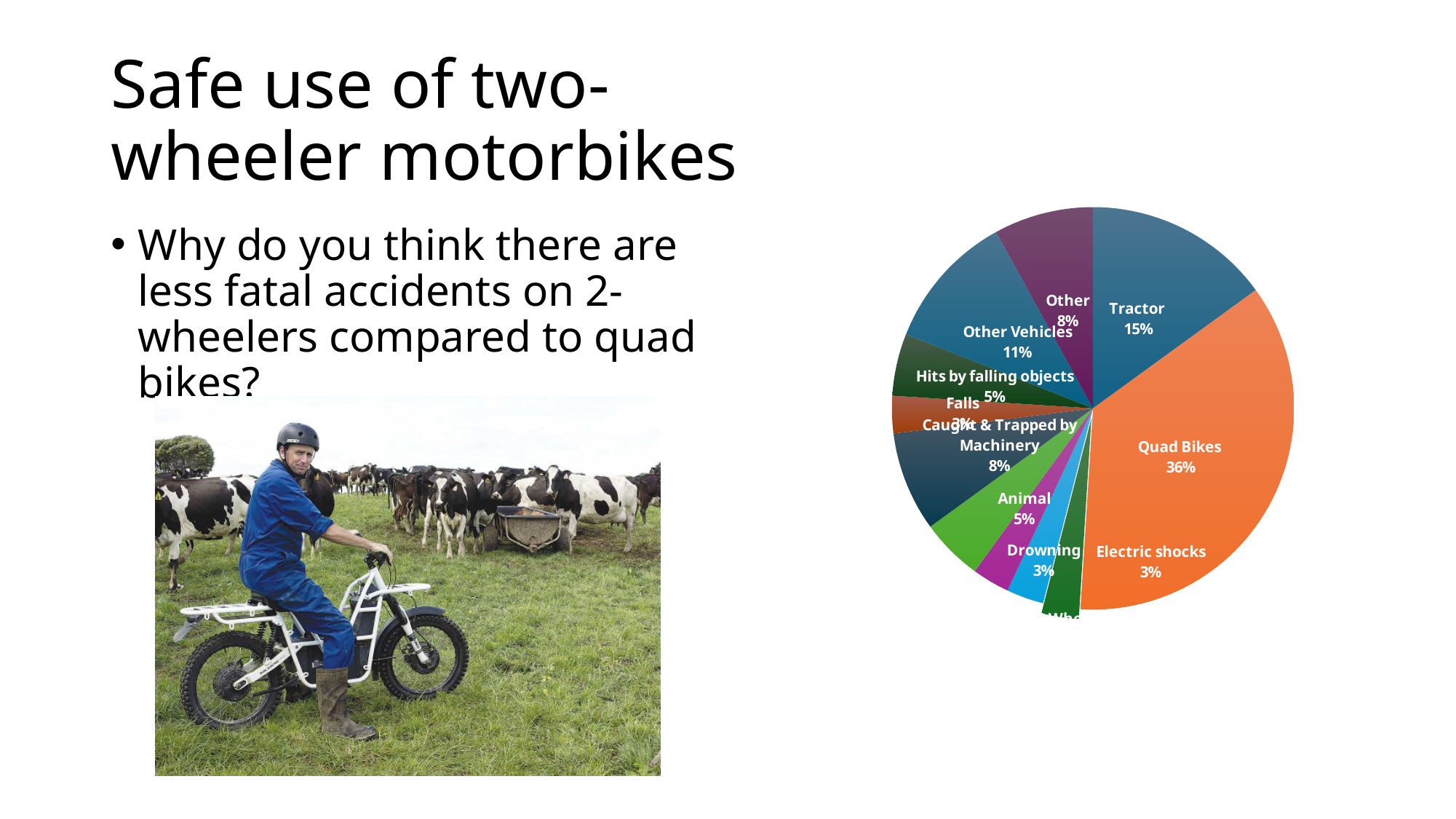
What percentage of the pie chart is Tractor? 15% What percentage of the pie chart is Caught & Trapped by Machinery? 8% What percentage of the pie chart is Drowning? 3% Which category has the largest slice of the pie chart? Quad Bikes What percentage of the pie chart is Animal? 5% What percentage of the pie chart is Quad Bikes? 36% Which slice is larger, Tractor or Other Vehicles? Tractor What percentage of the pie chart is Other Vehicles? 11% What kind of chart is shown on the slide? pie chart What percentage of the pie chart is Electric shocks? 3% What percentage of the pie chart is Hits by falling objects? 5% How many percentage points larger is the Quad Bikes slice than the Tractor slice? 21